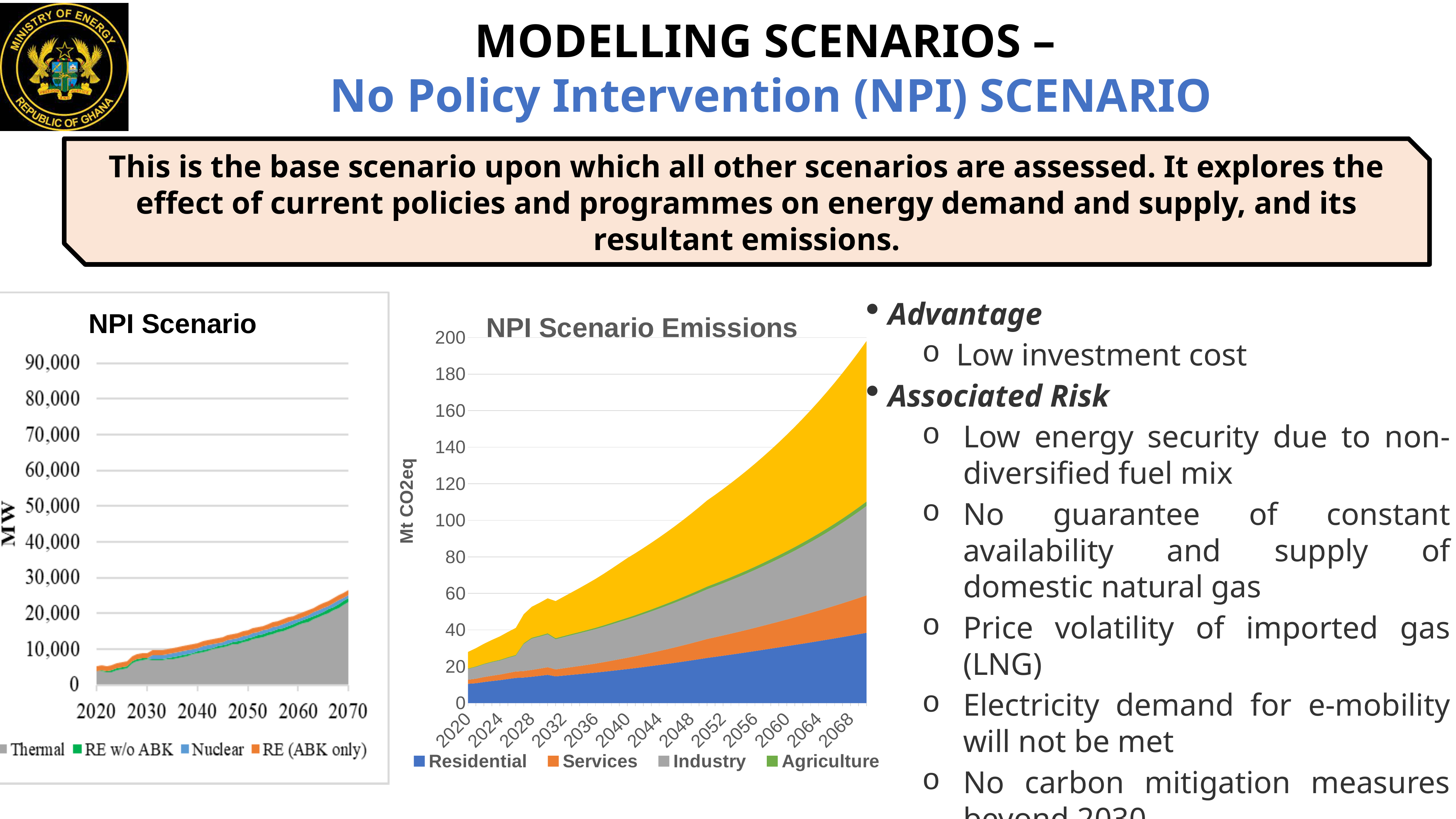
In the "NPI Scenario" chart, does the total capacity rise or fall from 2020 to 2070? Rise How many series does the legend of the "NPI Scenario" chart list? 4 In the "NPI Scenario Emissions" chart, are total emissions in 2020 greater or less than 40 Mt CO2eq? less What is the y-axis unit label on the "NPI Scenario Emissions" chart? Mt CO2eq What kind of chart is the "NPI Scenario" chart on the left? Stacked area chart In the "NPI Scenario Emissions" chart, do total emissions rise or fall from 2020 to 2068? Rise In the "NPI Scenario" chart, is the total capacity in 2070 greater or less than 20,000 MW? greater In the "NPI Scenario" chart, is the total capacity in 2020 greater or less than 10,000 MW? less Which series in the "NPI Scenario" chart is shown in grey? Thermal What kind of chart is the "NPI Scenario Emissions" chart? Stacked area chart How many series does the legend of the "NPI Scenario Emissions" chart list? 4